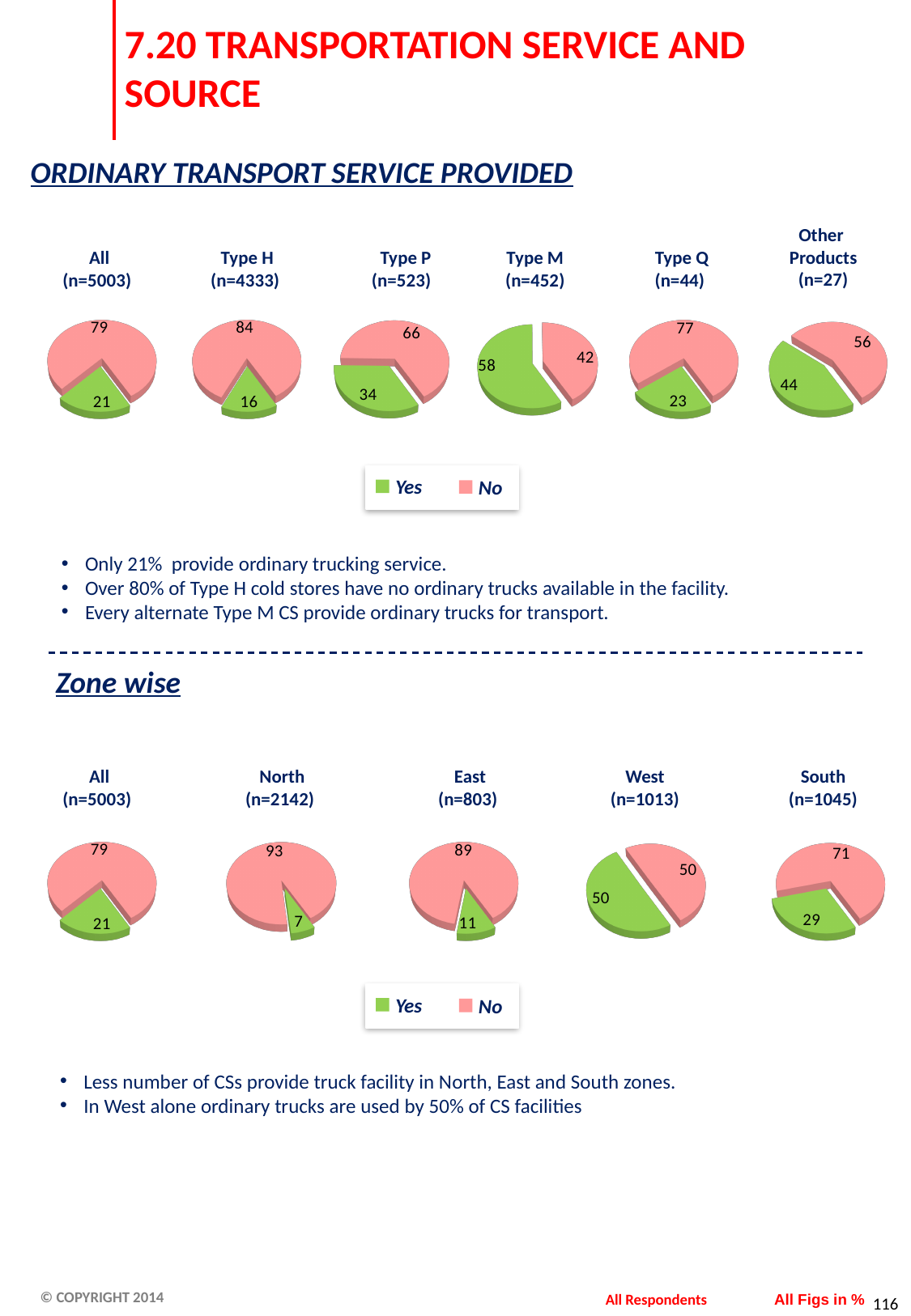
In the 'Zone wise' section, what is the 'Yes' value in the North (n=2142) pie chart? 7 In the 'Ordinary transport service provided' section, what is the 'Yes' value in the Type M (n=452) pie chart? 58 How many series does the legend below the 'Ordinary transport service provided' pie charts list? 2 How many pie charts are shown in the 'Zone wise' section? 5 In the 'Zone wise' section, which zone pie chart has the highest 'Yes' value? West (n=1013) In the 'Ordinary transport service provided' section, what is the 'Yes' value in the All (n=5003) pie chart? 21 In the 'Zone wise' section, is the 'Yes' value larger in the East (n=803) pie chart or the South (n=1045) pie chart? South (n=1045) In the 'Ordinary transport service provided' section, which pie chart has the highest 'Yes' value? Type M (n=452) In the 'Ordinary transport service provided' section, what is the difference between the 'No' and 'Yes' values in the Type P (n=523) pie chart? 32 In the 'Zone wise' section, what is the 'No' value in the South (n=1045) pie chart? 71 In the 'Ordinary transport service provided' section, what is the 'No' value in the Type H (n=4333) pie chart? 84 In the 'Ordinary transport service provided' section, which pie chart has the lowest 'Yes' value? Type H (n=4333)